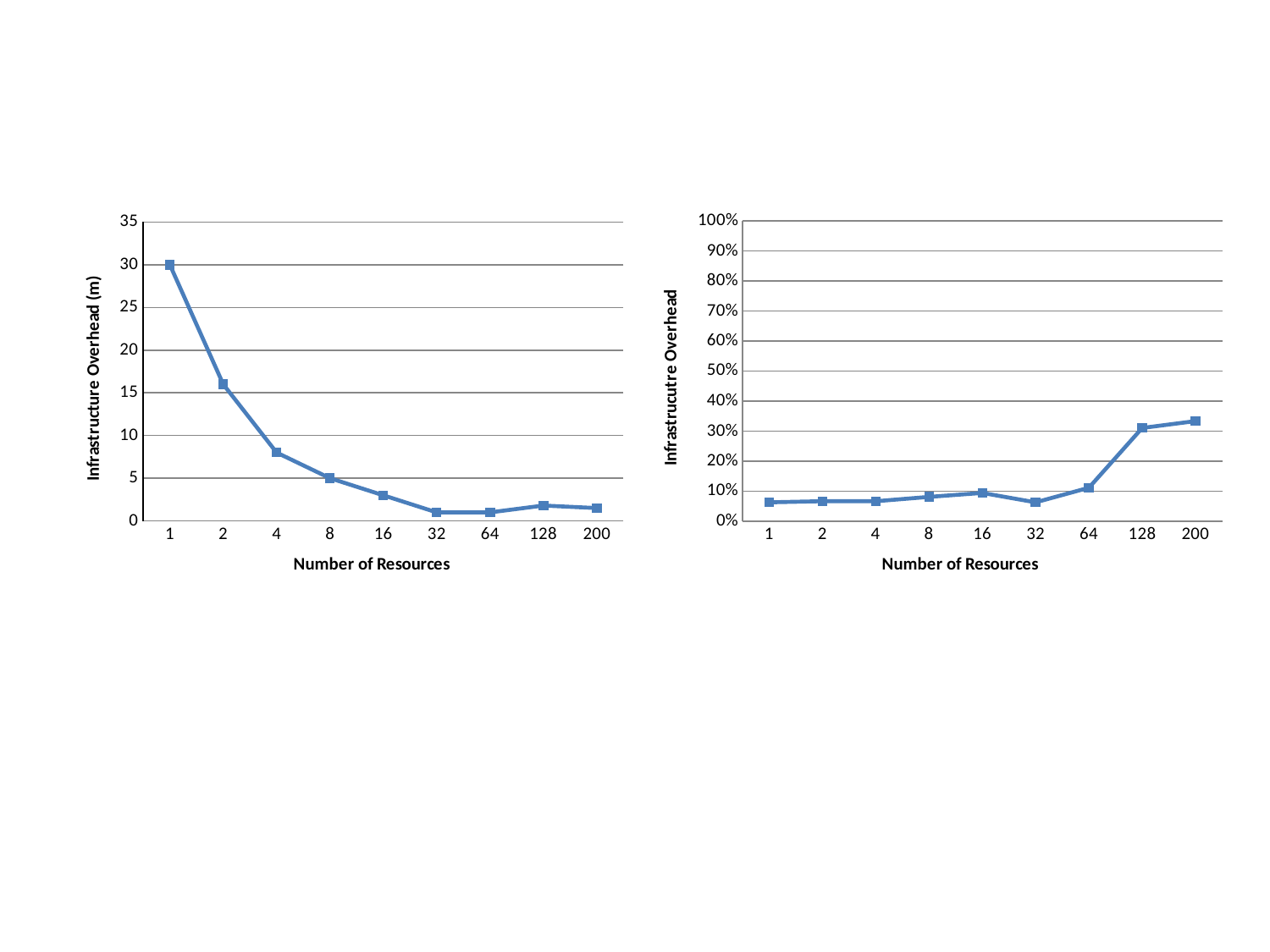
On the right chart, which number of resources has the highest infrastructure overhead? 200 On the left chart, which is larger: the infrastructure overhead for 4 resources or for 8 resources? 4 resources How many data points are plotted on the left chart? 9 What is the y-axis label of the left chart? Infrastructure Overhead (m) What kind of chart is the left chart? line chart On the right chart, is the infrastructure overhead for 128 resources greater or less than 20%? greater On the right chart, is the infrastructure overhead for 64 resources greater or less than 20%? less On the left chart, is the infrastructure overhead for 16 resources greater or less than 5? less On the right chart, which is larger: the infrastructure overhead for 64 resources or for 128 resources? 128 resources On the left chart, which number of resources has the highest infrastructure overhead? 1 On the left chart, do the values generally rise or fall as the number of resources increases from 1 to 32? fall